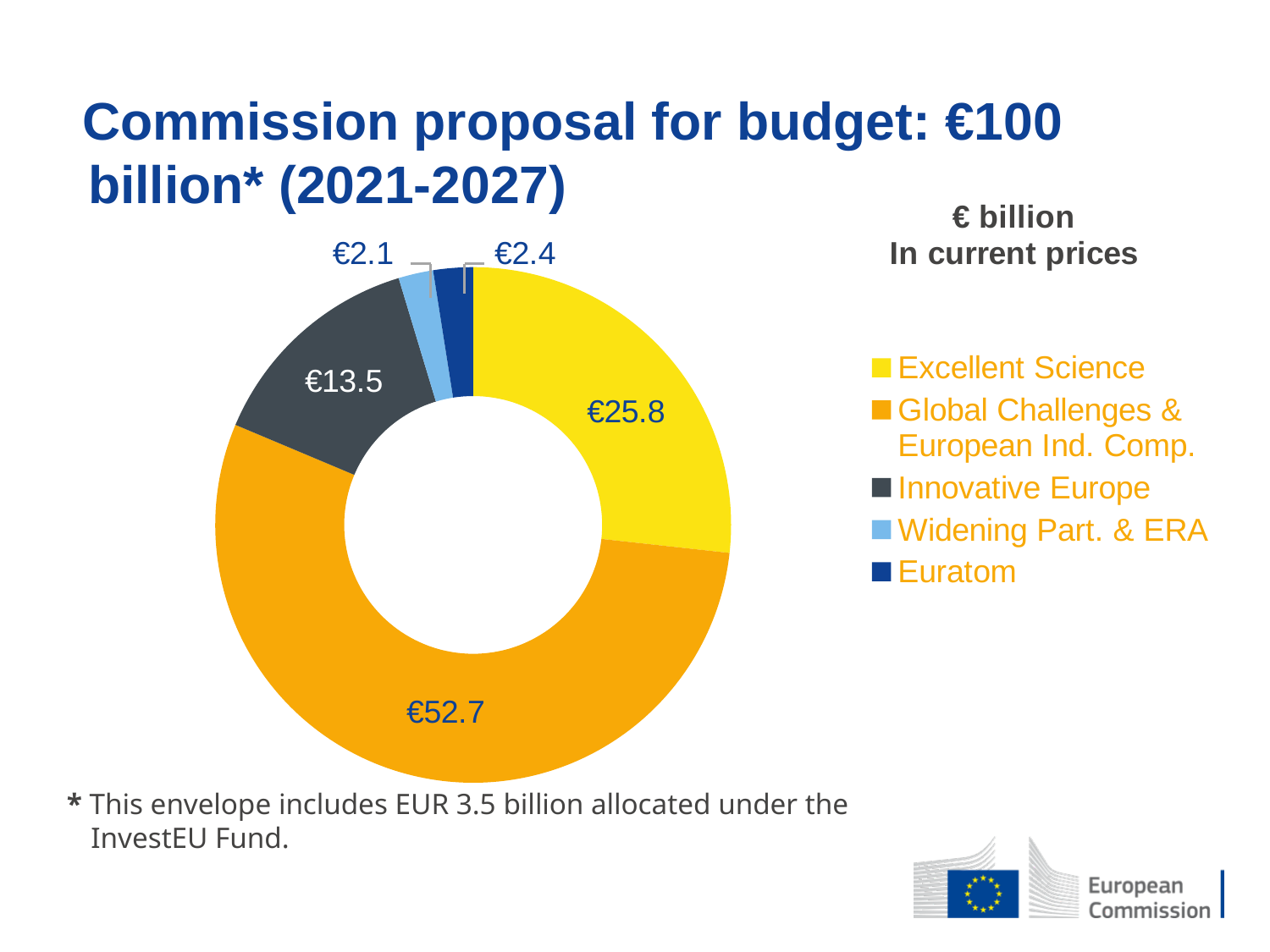
Which category has the largest slice? Global Challenges & European Ind. Comp. What is the value for Global Challenges & European Ind. Comp.? €52.7 What unit is stated for the chart values? € billion in current prices What is the value for Innovative Europe? €13.5 What is the difference between the values for Global Challenges & European Ind. Comp. and Excellent Science? €26.9 What is the value for Widening Part. & ERA? €2.1 Which is larger, the value for Euratom or the value for Widening Part. & ERA? Euratom What is the value for Euratom? €2.4 How many categories does the chart show? 5 What is the value for Excellent Science? €25.8 What kind of chart is shown on the slide? Doughnut chart Which category has the smallest slice? Widening Part. & ERA